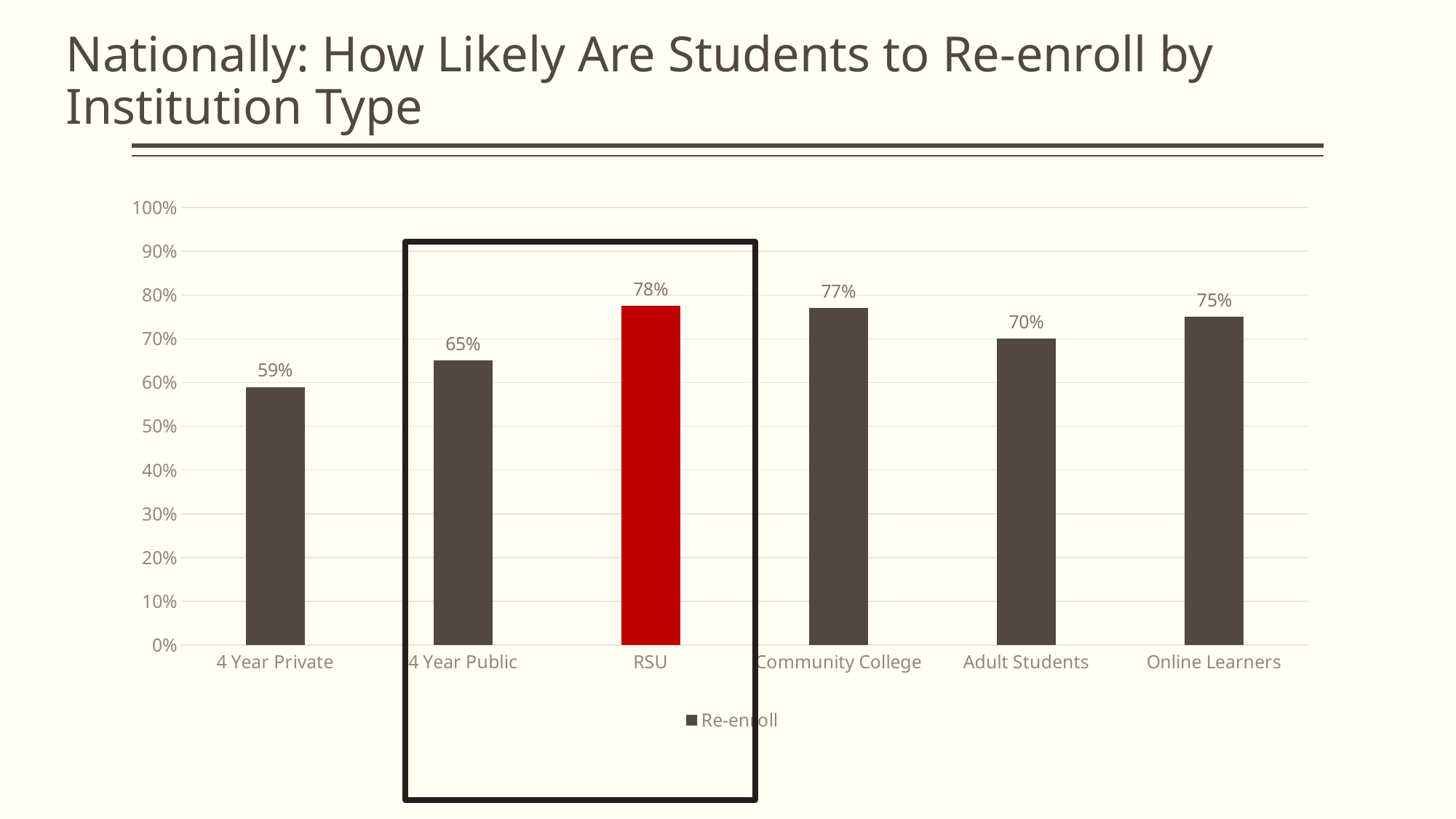
What is the difference between the re-enroll values for RSU and 4 Year Public? 13% How many institution types are shown on the chart? 6 What is the re-enroll value for RSU? 78% What kind of chart is shown on the slide? bar chart Which category has the lowest re-enroll value? 4 Year Private How many series does the legend list? 1 What is the re-enroll value for 4 Year Private? 59% Which is larger, the re-enroll value for Community College or for Online Learners? Community College Is the re-enroll value for 4 Year Public greater or less than 60%? greater Which bar is coloured red? RSU What is the re-enroll value for Adult Students? 70% What is the difference between the re-enroll values for Online Learners and Adult Students? 5%